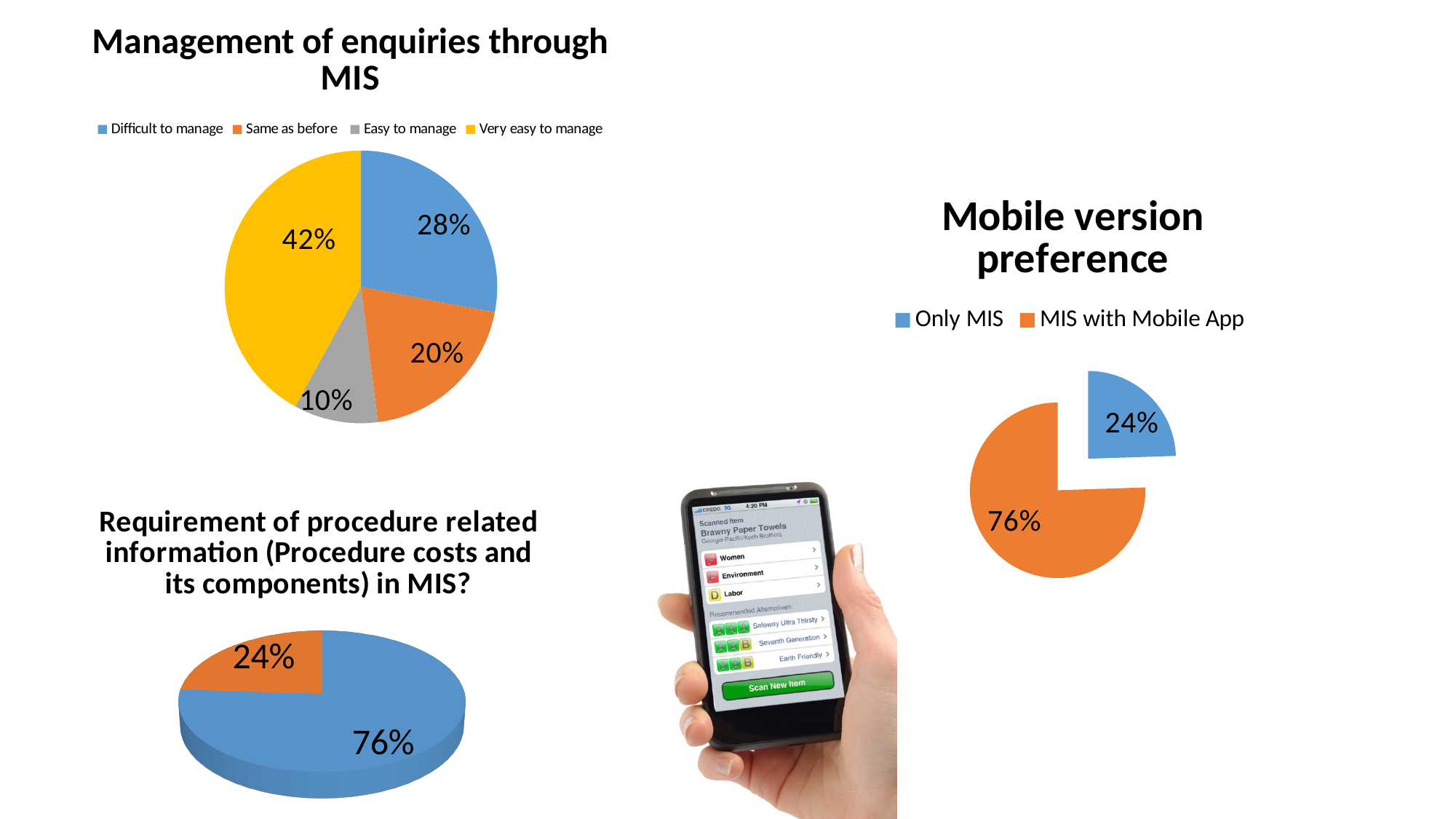
In the 'Management of enquiries through MIS' chart, what percentage of respondents found enquiries 'Very easy to manage'? 42% What type of chart is the 'Mobile version preference' chart? Pie chart In the 'Management of enquiries through MIS' chart, what percentage of respondents said 'Difficult to manage'? 28% In the 'Requirement of procedure related information' chart at the bottom left, what percentage is shown on the larger blue slice? 76% In the 'Management of enquiries through MIS' chart, which category has the smallest share? Easy to manage In the 'Management of enquiries through MIS' chart, which category has the largest share? Very easy to manage In the 'Mobile version preference' chart, what percentage of respondents preferred 'MIS with Mobile App'? 76% How many categories does the legend of the 'Management of enquiries through MIS' chart list? 4 In the 'Mobile version preference' chart, what percentage of respondents preferred 'Only MIS'? 24% In the 'Management of enquiries through MIS' chart, what is the difference between the 'Very easy to manage' and 'Same as before' shares? 22% In the 'Management of enquiries through MIS' chart, what percentage of respondents said 'Easy to manage'? 10% In the 'Mobile version preference' chart, which option is larger: 'Only MIS' or 'MIS with Mobile App'? MIS with Mobile App